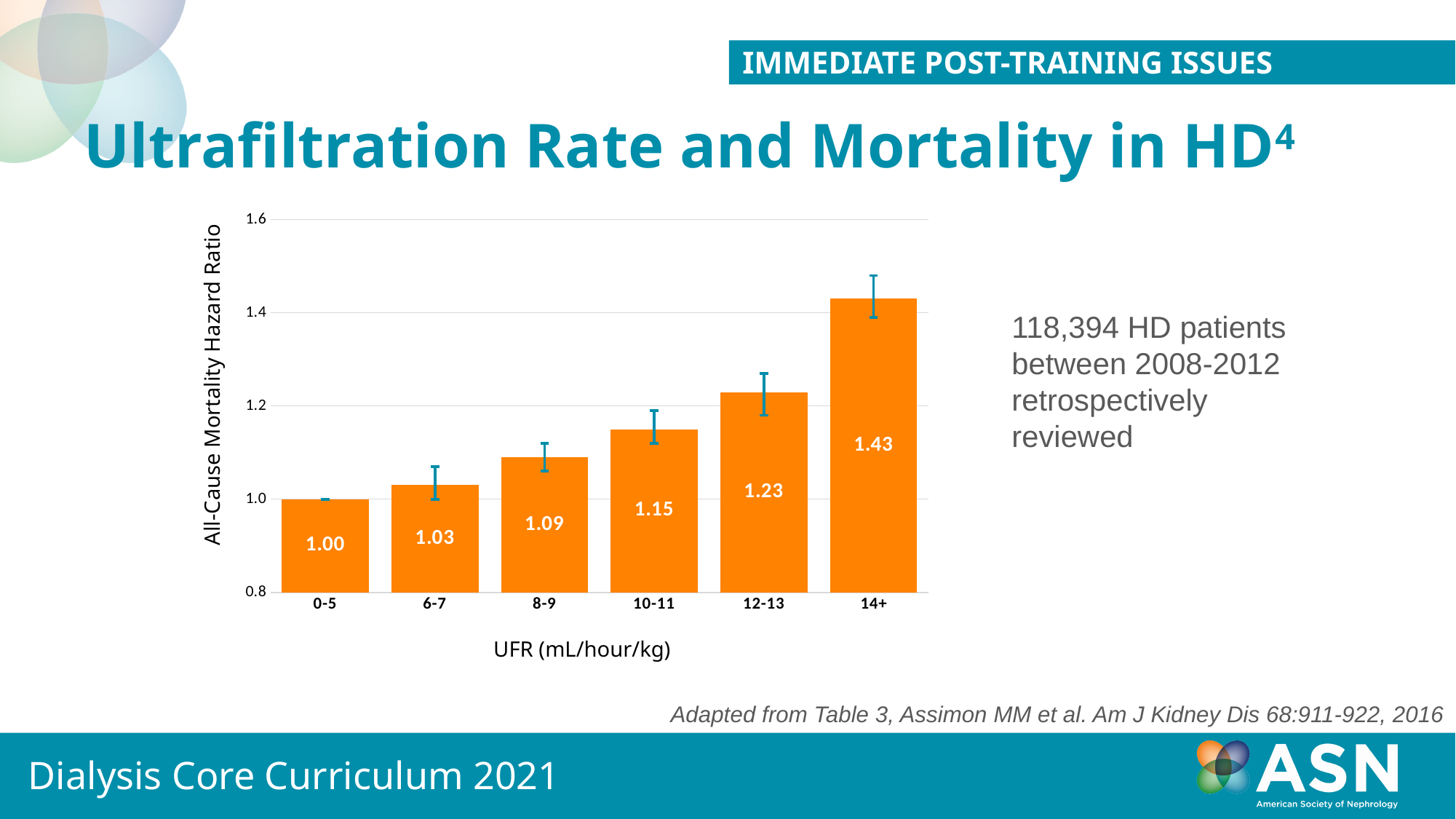
Is the hazard ratio for the 14+ UFR category greater or less than 1.4? greater What is the hazard ratio for the 6-7 UFR category? 1.03 Which UFR category has the lowest all-cause mortality hazard ratio? 0-5 What is the all-cause mortality hazard ratio for the UFR category 10-11 mL/hour/kg? 1.15 Which UFR category has the highest all-cause mortality hazard ratio? 14+ Which has a higher hazard ratio, the 8-9 or the 12-13 UFR category? 12-13 What is the difference in hazard ratio between the 14+ and 0-5 UFR categories? 0.43 What kind of chart is used to show the hazard ratios? Bar chart What is the difference in hazard ratio between the 12-13 and 8-9 UFR categories? 0.14 Do the hazard ratios rise or fall as UFR increases along the x axis? Rise How many UFR categories are shown on the x axis? 6 What is the hazard ratio shown for the 14+ UFR category? 1.43